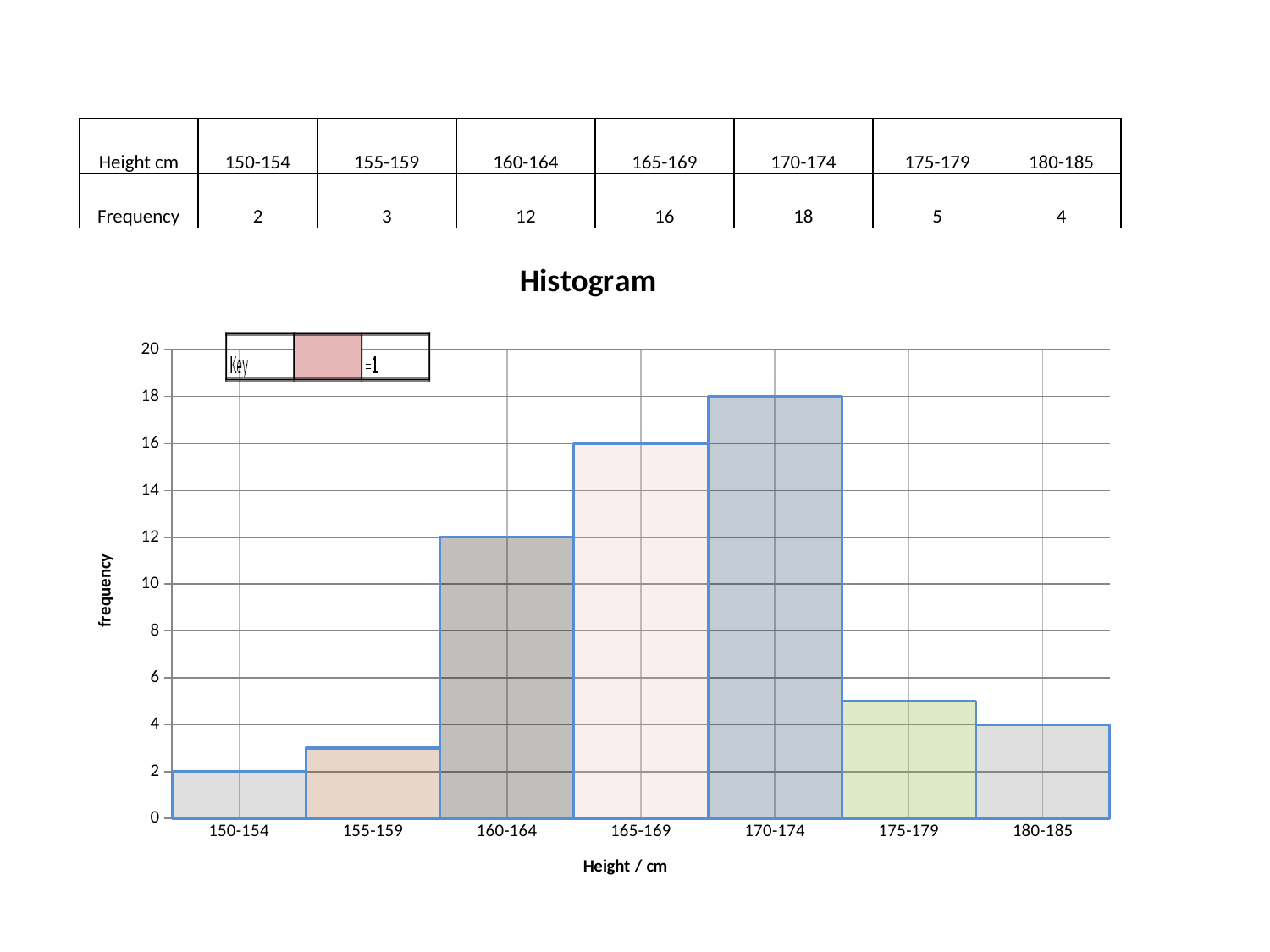
What is the frequency for the 170-174 height group? 18 What is the difference in frequency between the 170-174 and 165-169 groups? 2 Which height group has the lowest frequency? 150-154 Which height group has the highest frequency? 170-174 What is the label on the y axis of the chart? frequency What is the difference in frequency between the 160-164 and 155-159 groups? 9 What is the frequency for the 180-185 height group? 4 What is the title of the chart? Histogram Is the frequency for the 165-169 group greater or less than 10? greater What is the frequency for the 160-164 height group? 12 How many height groups are shown on the x axis? 7 Which has a higher frequency, the 175-179 group or the 180-185 group? 175-179